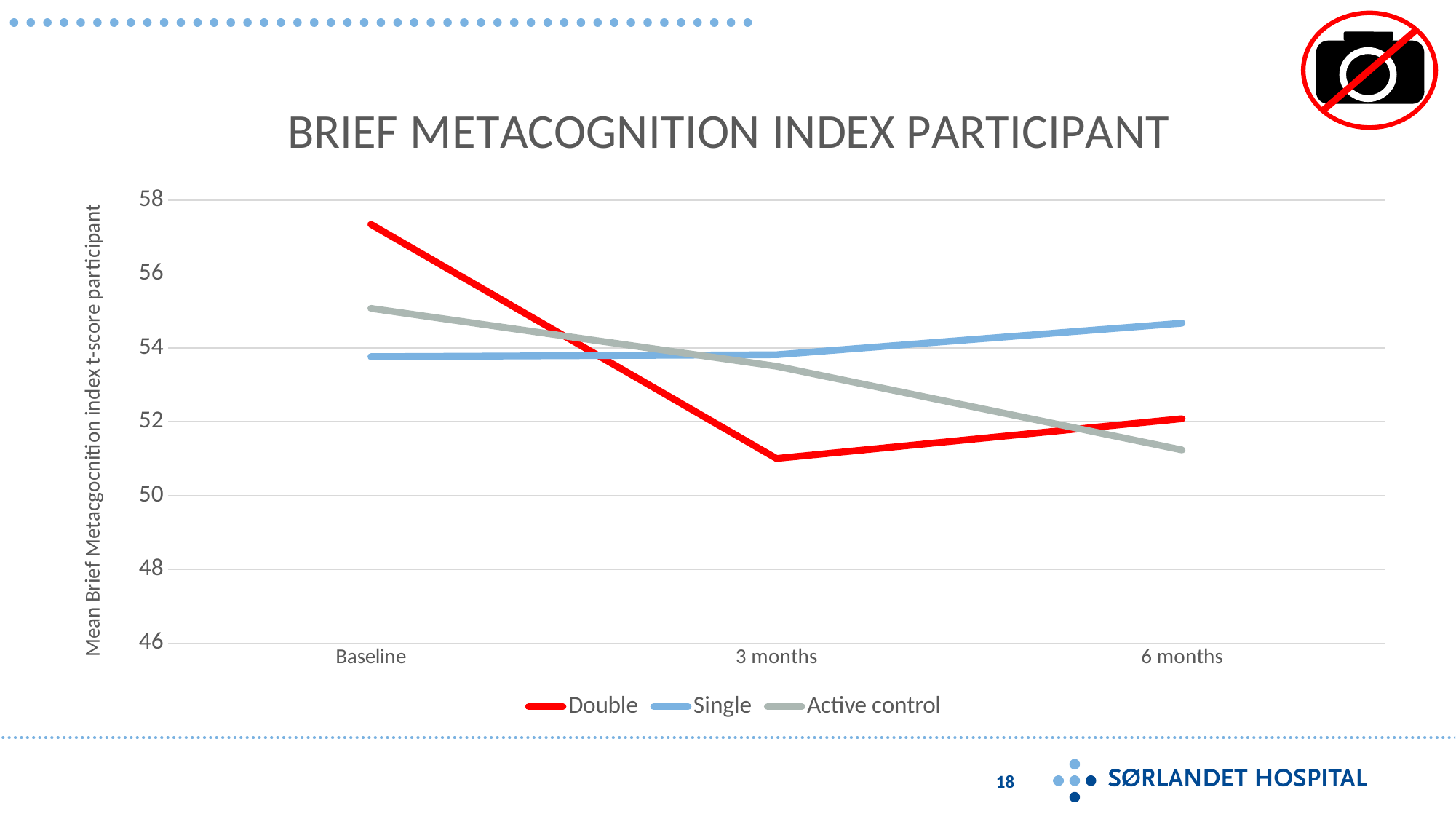
Which series has the lowest value at 6 months? Active control What is the label of the y axis? Mean Brief Metacgocnition index t-score participant What kind of chart is shown on the slide? line chart Is the value for Active control at 6 months greater or less than 52? less Is the value for Double at 3 months greater or less than 52? less Does the Active control series rise or fall from Baseline to 6 months? fall How many series does the legend list? 3 Which series has the lowest value at 3 months? Double Which series has the highest value at Baseline? Double Which series has the highest value at 6 months? Single Is the value for Double at Baseline greater or less than 56? greater How many time points are shown on the x axis? 3